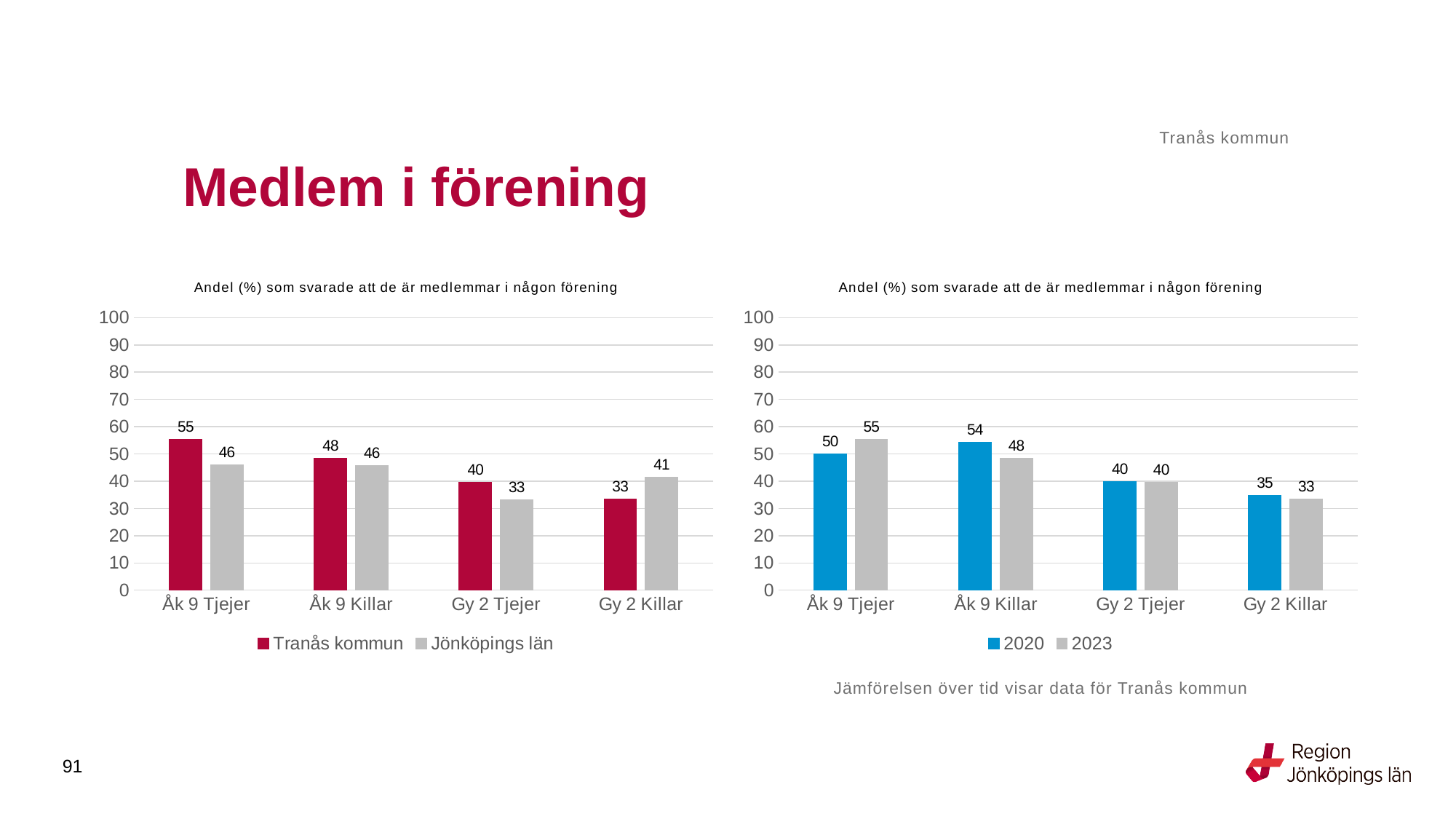
What kind of chart is the right chart? Bar chart How many series does the legend of the left chart list? 2 In the left chart, which is larger for Gy 2 Killar: Tranås kommun or Jönköpings län? Jönköpings län In the left chart, which category has the highest value for Tranås kommun? Åk 9 Tjejer In the right chart, what is the difference between 2020 and 2023 for Åk 9 Killar? 6 In the left chart, what is the value for Tranås kommun for Åk 9 Tjejer? 55 In the left chart, what is the difference between Tranås kommun and Jönköpings län for Gy 2 Tjejer? 7 How many categories are shown on the x axis of the right chart? 4 In the right chart, what is the value for 2023 for Gy 2 Killar? 33 In the right chart, what is the value for 2020 for Åk 9 Killar? 54 In the left chart, what is the value for Jönköpings län for Gy 2 Killar? 41 In the right chart, which category has the lowest value for 2020? Gy 2 Killar